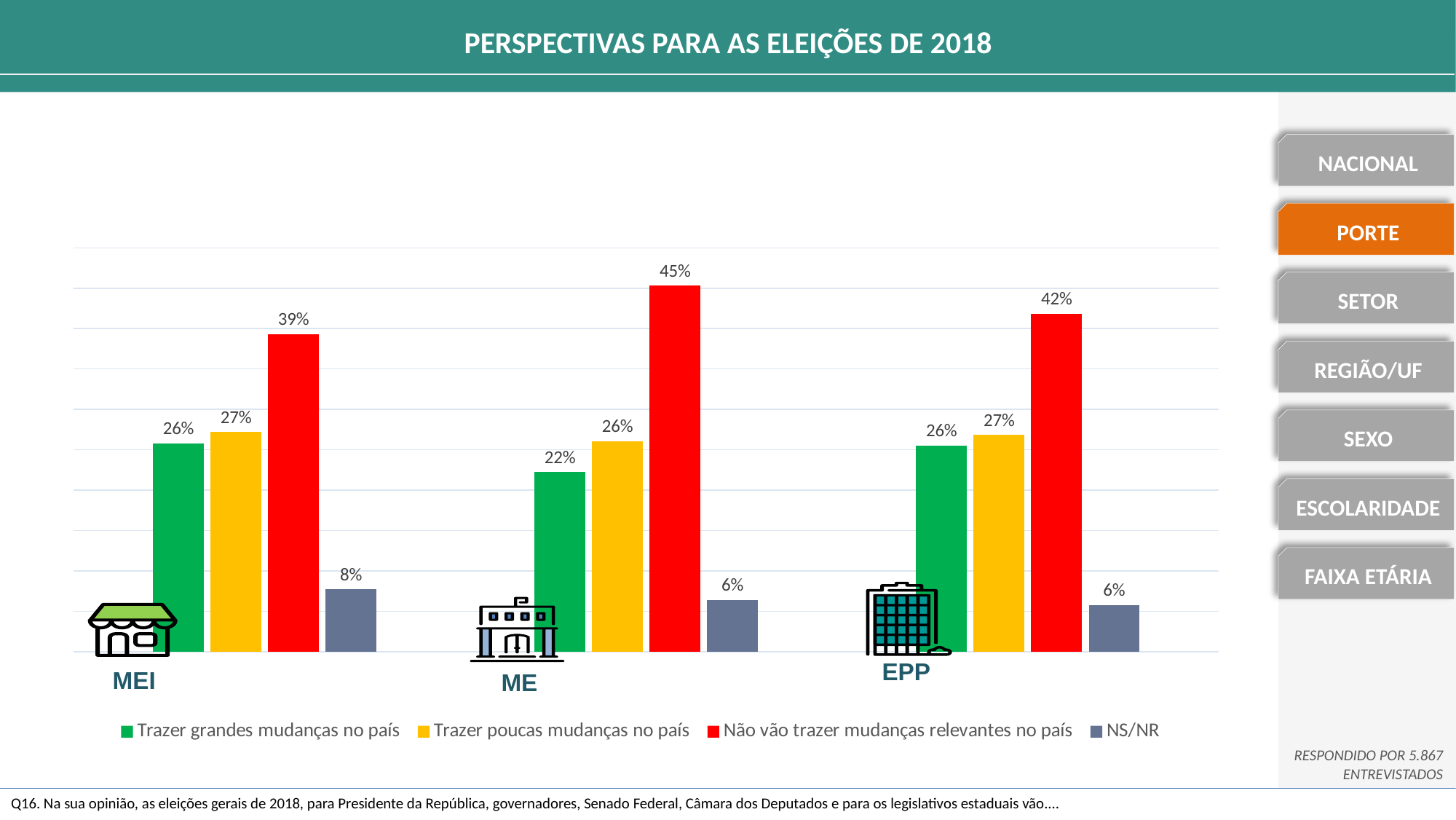
What is the difference between the "Não vão trazer mudanças relevantes no país" values for ME and MEI? 6% What colour represents "NS/NR" in the chart? Grey-blue How many series does the legend list? 4 What kind of chart is shown on the slide? Bar chart What is the value for "Trazer poucas mudanças no país" for ME? 26% What is the value for "Trazer grandes mudanças no país" for MEI? 26% Which is larger for EPP: "Trazer grandes mudanças no país" or "Não vão trazer mudanças relevantes no país"? Não vão trazer mudanças relevantes no país What is the value for "Não vão trazer mudanças relevantes no país" for ME? 45% Which category has the lowest value for "Trazer grandes mudanças no país"? ME What is the NS/NR value for EPP? 6% How many categories are shown on the x axis? 3 Which category has the highest value for "Não vão trazer mudanças relevantes no país"? ME